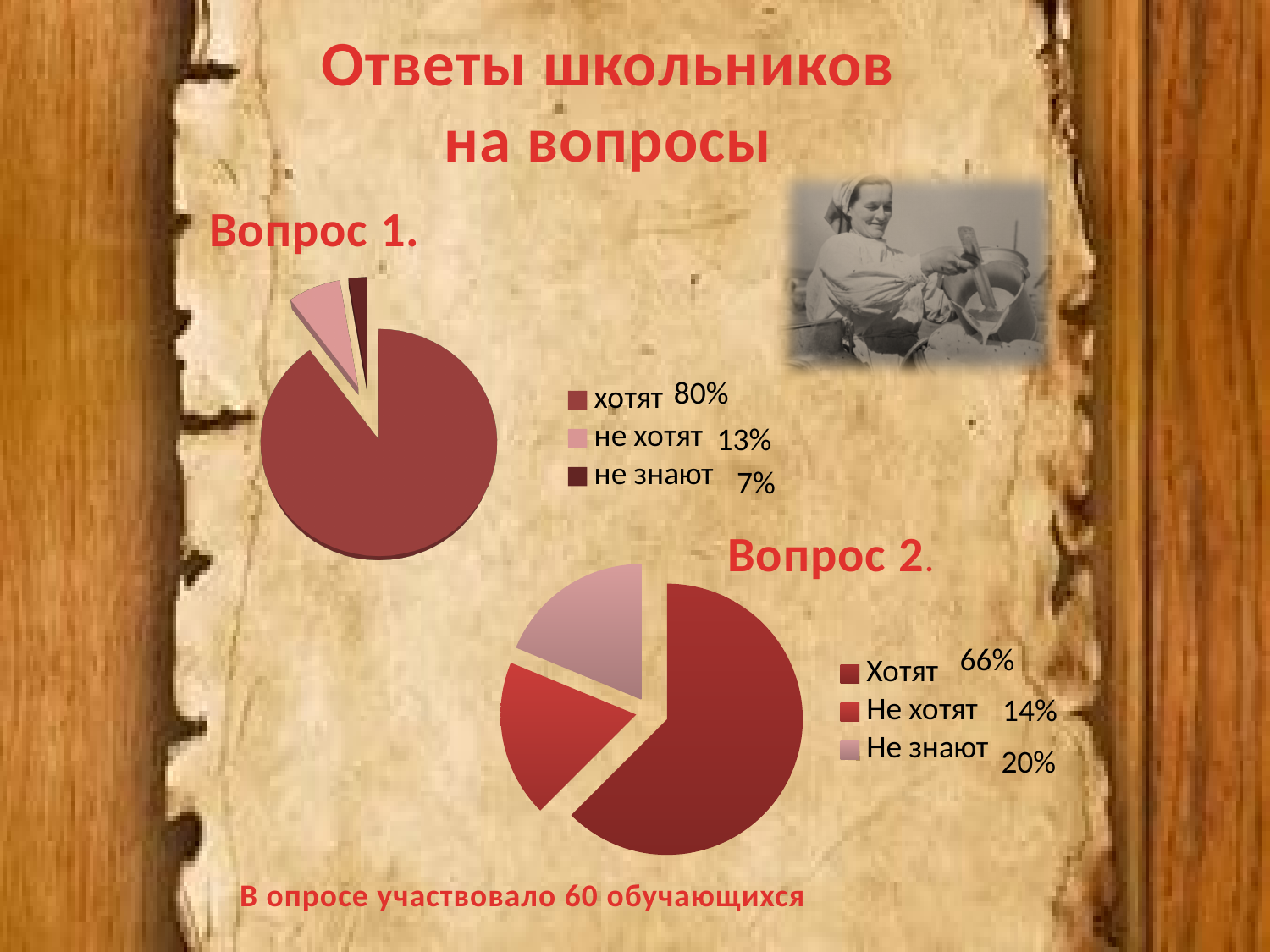
Which is larger: the 'хотят' share in the 'Вопрос 1.' chart or the 'Хотят' share in the 'Вопрос 2.' chart? Вопрос 1. How many slices does the 'Вопрос 2.' pie chart have? 3 In the 'Вопрос 1.' chart, what is the difference between the shares for 'хотят' and 'не хотят'? 67% In the 'Вопрос 1.' chart, which answer has the largest share? хотят In the 'Вопрос 2.' chart, which answer has the smallest share? Не хотят In the 'Вопрос 2.' chart, what is the difference between the shares for 'Не знают' and 'Не хотят'? 6% In the 'Вопрос 2.' chart, what share of respondents answered 'Не знают'? 20% In the 'Вопрос 1.' chart, what share of respondents answered 'не знают'? 7% In the 'Вопрос 1.' chart, what share of respondents answered 'хотят'? 80% What type of chart is used for 'Вопрос 1.'? Pie chart How many entries does the legend of the 'Вопрос 1.' chart list? 3 In the 'Вопрос 2.' chart, what share of respondents answered 'Не хотят'? 14%